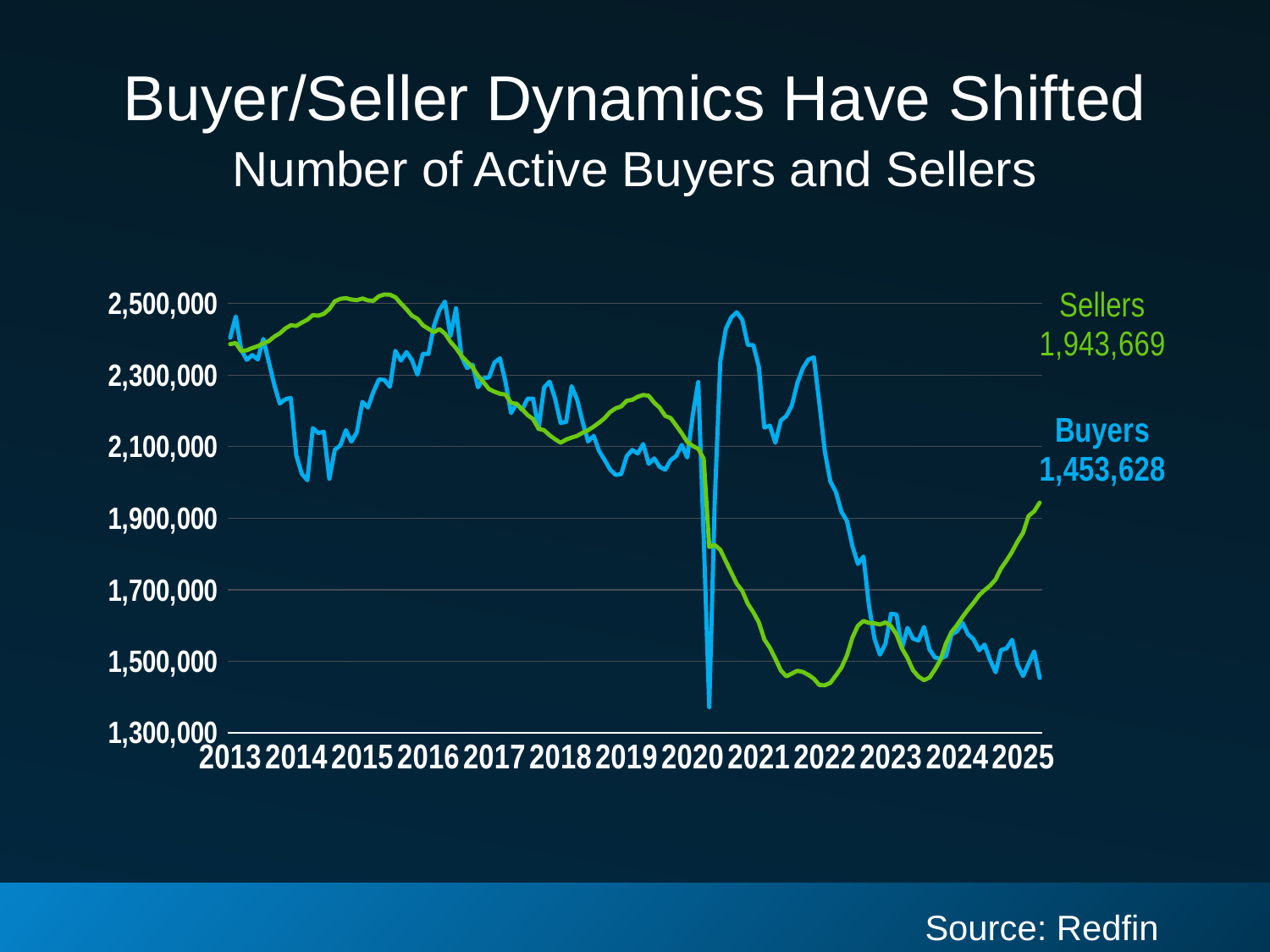
What colour is the Sellers line? green Is the Sellers value in 2015 greater or less than 2,300,000? greater Is the final Buyers value greater or less than 1,500,000? less How many series does the chart show? 2 What kind of chart is shown on the slide? line chart What is the difference between the labelled Sellers value and the labelled Buyers value? 490,041 What is the latest value shown for Buyers? 1,453,628 Do the Sellers values rise or fall from 2023 to 2025? rise At the end of the chart, which is larger: the number of Sellers or the number of Buyers? Sellers Do the Buyers values rise or fall from 2022 to 2025? fall How many year labels are shown on the x axis? 13 What is the latest value shown for Sellers? 1,943,669